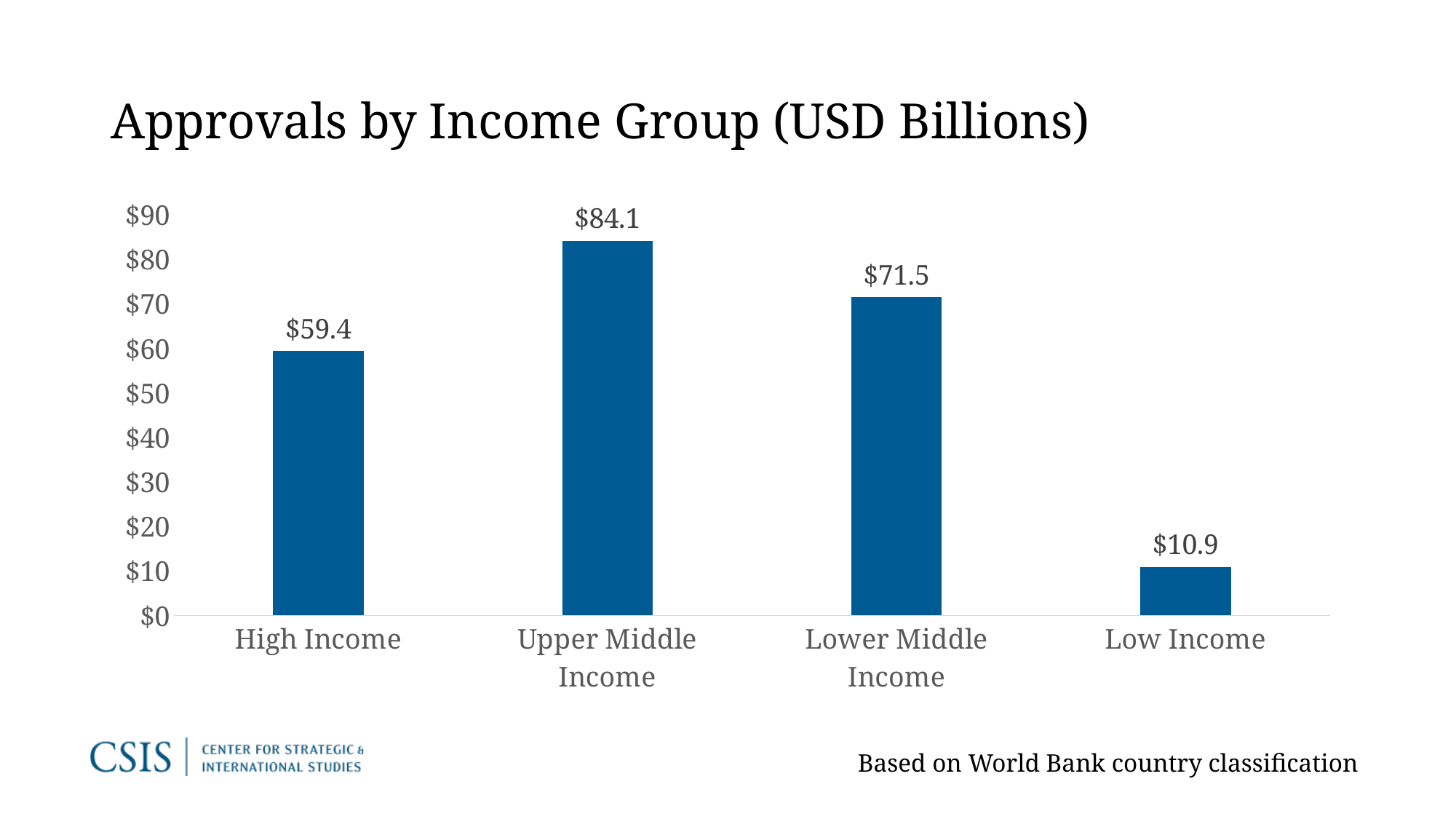
Which income group has the highest approvals? Upper Middle Income What is the difference between the values for Upper Middle Income and Lower Middle Income? $12.6 What kind of chart is shown on the slide? bar chart What is the value for Lower Middle Income? $71.5 What is the difference between the values for High Income and Low Income? $48.5 What is the value for Upper Middle Income? $84.1 Which is larger, the value for High Income or the value for Lower Middle Income? Lower Middle Income What is the value for High Income? $59.4 Which income group has the lowest approvals? Low Income How many income groups are shown in the chart? 4 What is the value for Low Income? $10.9 Is the value for Upper Middle Income greater or less than $80? greater